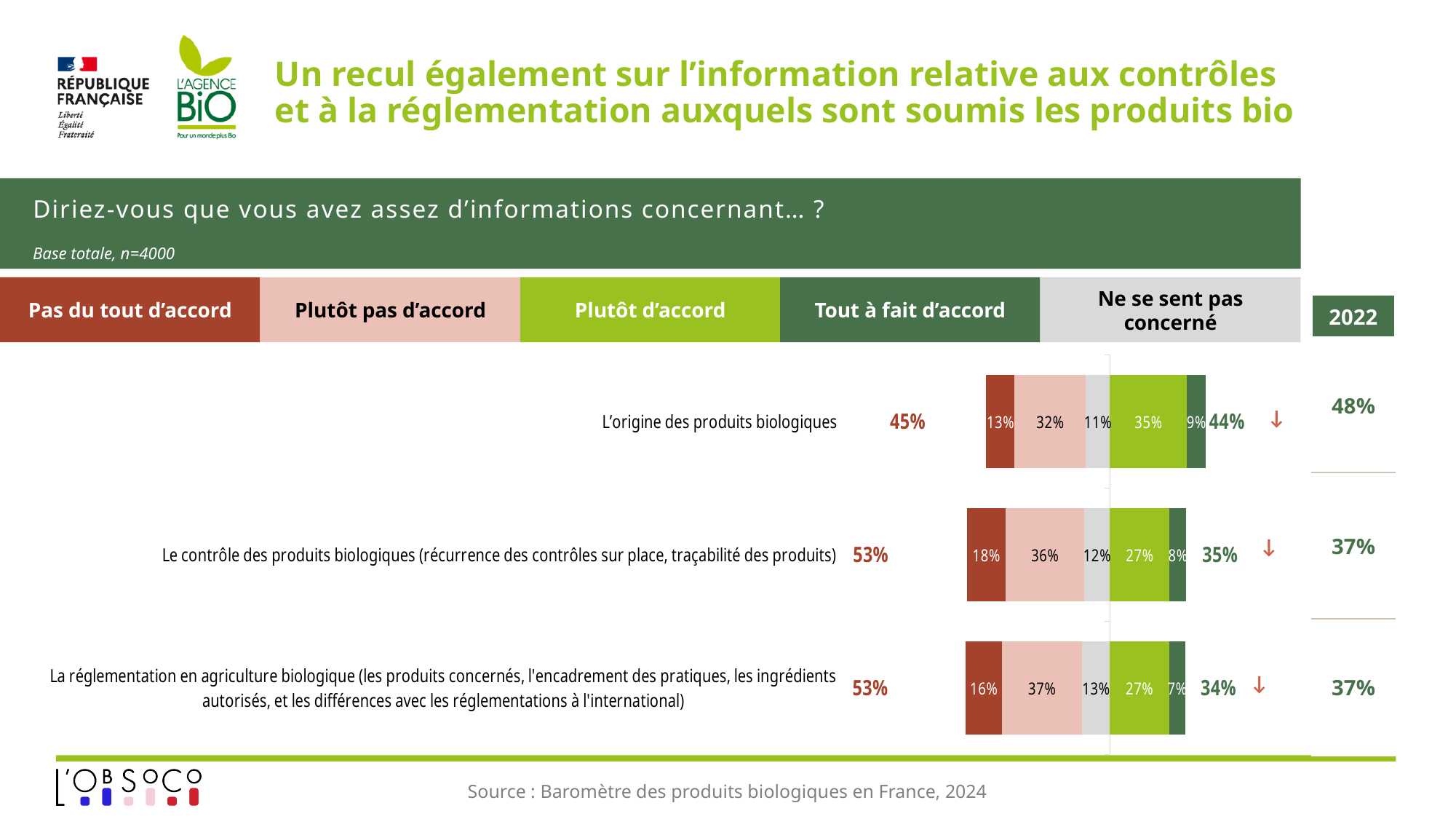
What is the combined agreement total ('Plutôt d'accord' plus 'Tout à fait d'accord') shown for 'Le contrôle des produits biologiques'? 35% What was the 2022 agreement figure shown for 'L'origine des produits biologiques'? 48% Which item has the lowest 'Tout à fait d'accord' percentage? La réglementation en agriculture biologique What type of chart is shown on the slide? Stacked bar chart How many items (categories) are shown in the chart? 3 What is the difference between the 'Plutôt pas d'accord' values for 'La réglementation en agriculture biologique' and 'L'origine des produits biologiques'? 5 points What is the 'Ne se sent pas concerné' share for 'La réglementation en agriculture biologique'? 13% How many response categories does the legend list? 5 Which item has the highest 'Tout à fait d'accord' percentage? L'origine des produits biologiques What percentage of respondents answered 'Plutôt d'accord' for 'L'origine des produits biologiques'? 35% What is the 'Pas du tout d'accord' value for 'Le contrôle des produits biologiques'? 18% Which is larger: the 'Plutôt pas d'accord' value for 'Le contrôle des produits biologiques' or for 'L'origine des produits biologiques'? Le contrôle des produits biologiques